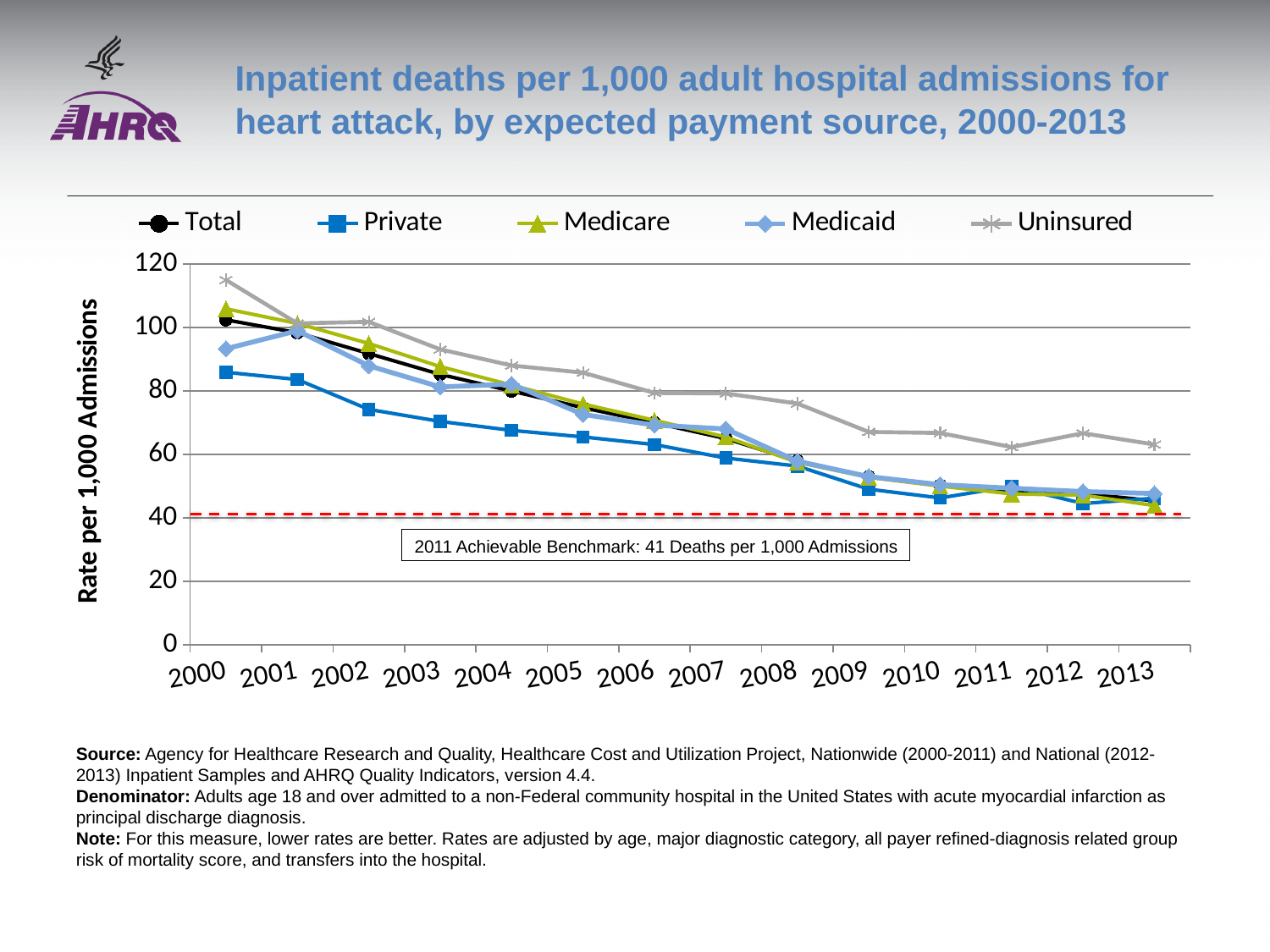
What kind of chart is shown on the slide? line chart Do the values for the Total series rise or fall from 2000 to 2013? fall Which payment source has the highest rate in 2000? Uninsured What is the 2011 achievable benchmark shown on the chart? 41 Deaths per 1,000 Admissions How many series does the legend list? 5 How many years are plotted along the x axis? 14 In 2005, which is larger, the rate for Uninsured or the rate for Private? Uninsured Which payment source has the highest rate in 2013? Uninsured Is the value for Uninsured in 2000 greater or less than 100? greater Is the value for Private in 2000 greater or less than 100? less Which payment source has the lowest rate in 2000? Private Is the value for Private in 2013 greater or less than 60? less